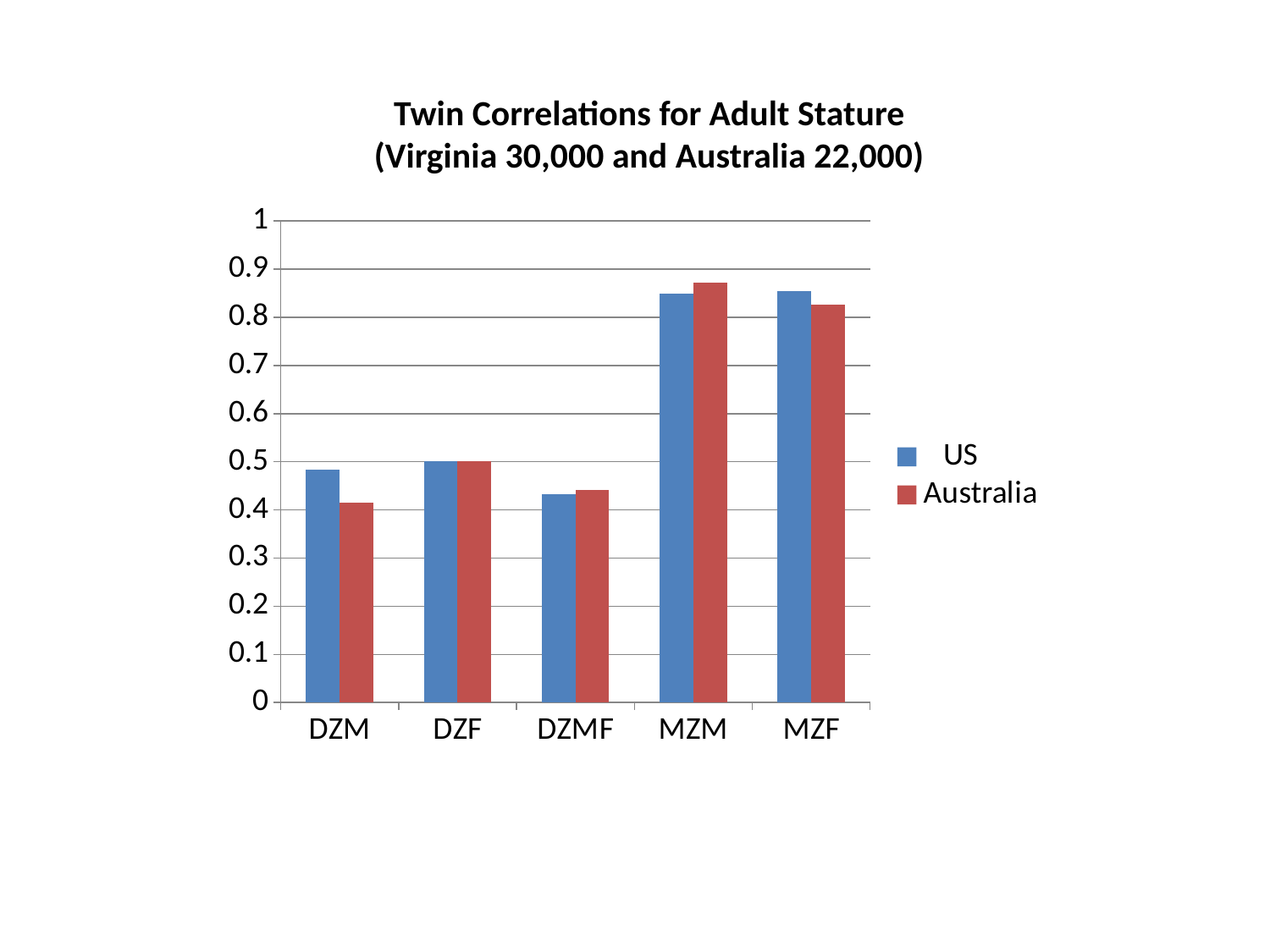
How many twin categories are shown on the x axis? 5 Which category has the lowest Australia value? DZM For DZM, which is larger, the US value or the Australia value? US What is the title of the chart? Twin Correlations for Adult Stature (Virginia 30,000 and Australia 22,000) Which category has the highest Australia value? MZM Is the Australia value for DZM greater or less than 0.5? less Which colour represents the Australia series? red For MZF, which is larger, the US value or the Australia value? US Is the Australia value for MZM greater or less than 0.8? greater What kind of chart is shown on the slide? bar chart How many series does the legend list? 2 Which category has the lowest US value? DZMF